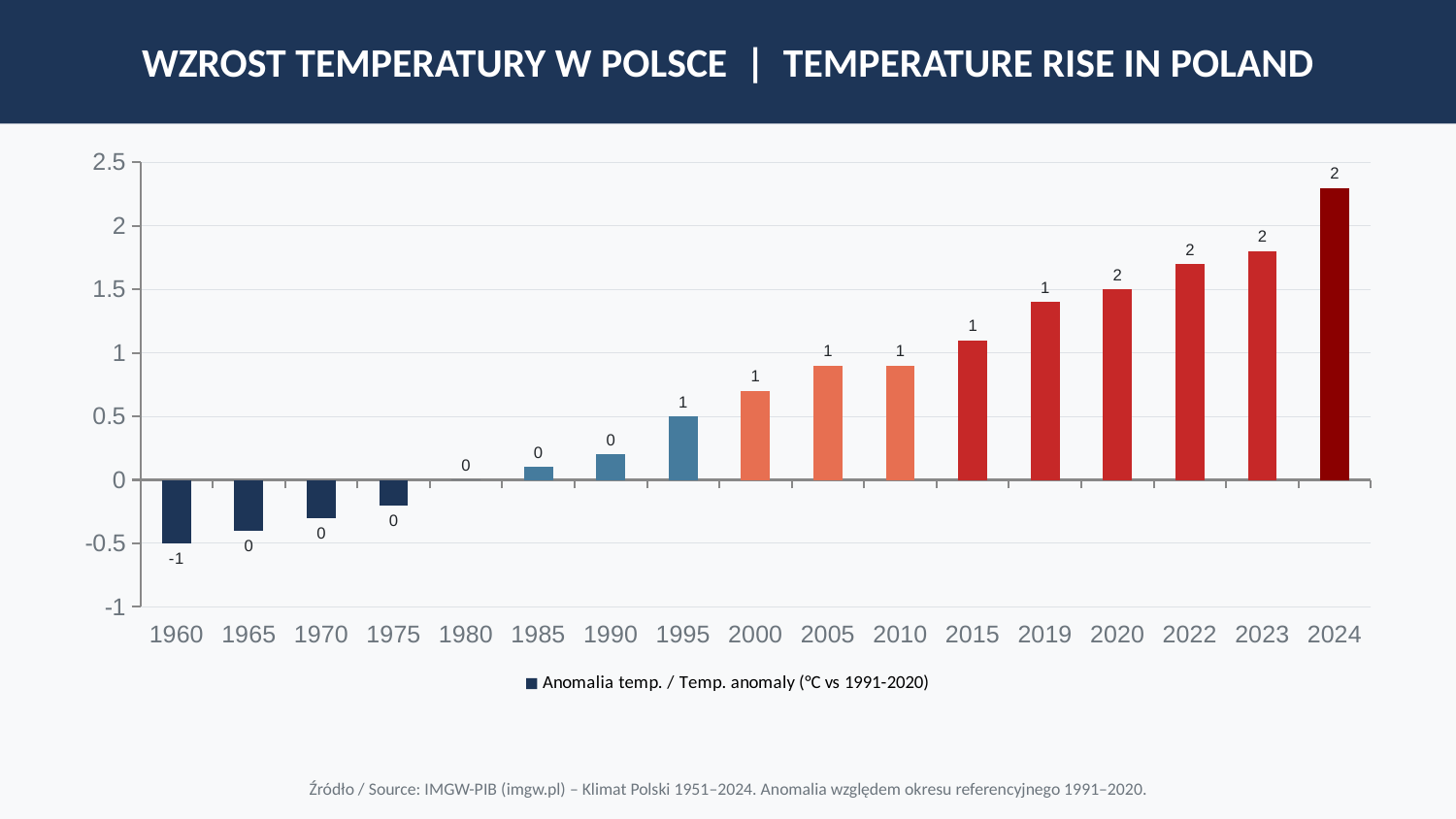
How many series does the legend list? 1 What is the data label shown for 2024? 2 What type of chart is shown on the slide? bar chart How many years are shown on the x axis of the chart? 17 Which year has the lowest temperature anomaly in the chart? 1960 Is the value for 2024 greater or less than 2? greater Which year has the larger value, 2023 or 2024? 2024 What is the data label shown for 1960? -1 Is the value for 1970 greater or less than 0? less Do the values generally rise or fall from 1960 to 2024? rise Is the value for 2015 greater or less than 1? greater Which year has the highest temperature anomaly in the chart? 2024